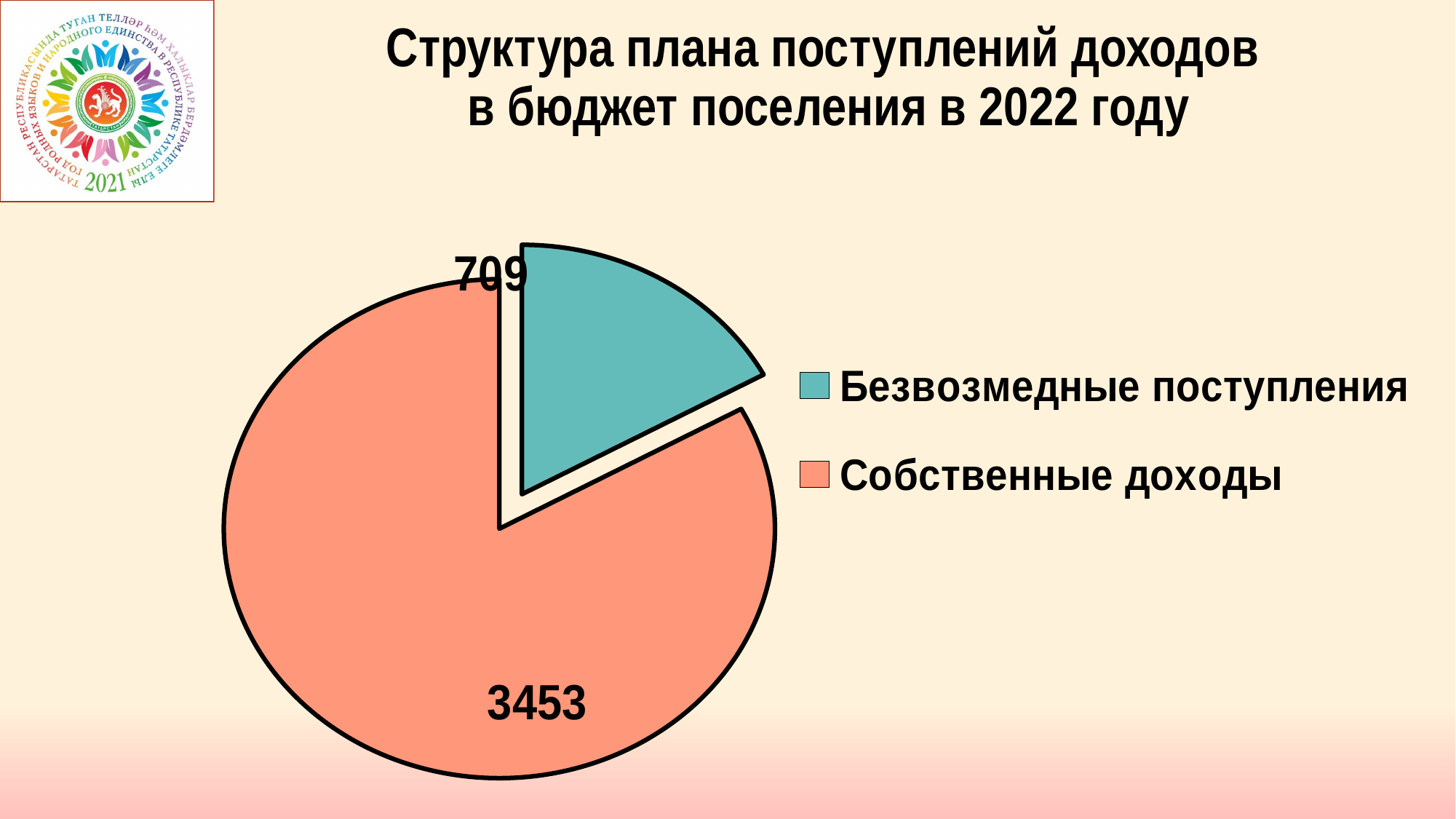
Which category has the smallest slice of the pie? Безвозмедные поступления What is the value for Безвозмедные поступления? 709 What is the difference between the values for Собственные доходы and Безвозмедные поступления? 2744 What colour is the slice for Безвозмедные поступления? teal How many entries does the legend list? 2 Which is larger: Безвозмедные поступления or Собственные доходы? Собственные доходы What type of chart is shown on the slide? pie chart Which category has the largest slice of the pie? Собственные доходы What is the total of all slices in the pie chart? 4162 How many slices does the pie chart have? 2 What is the value for Собственные доходы? 3453